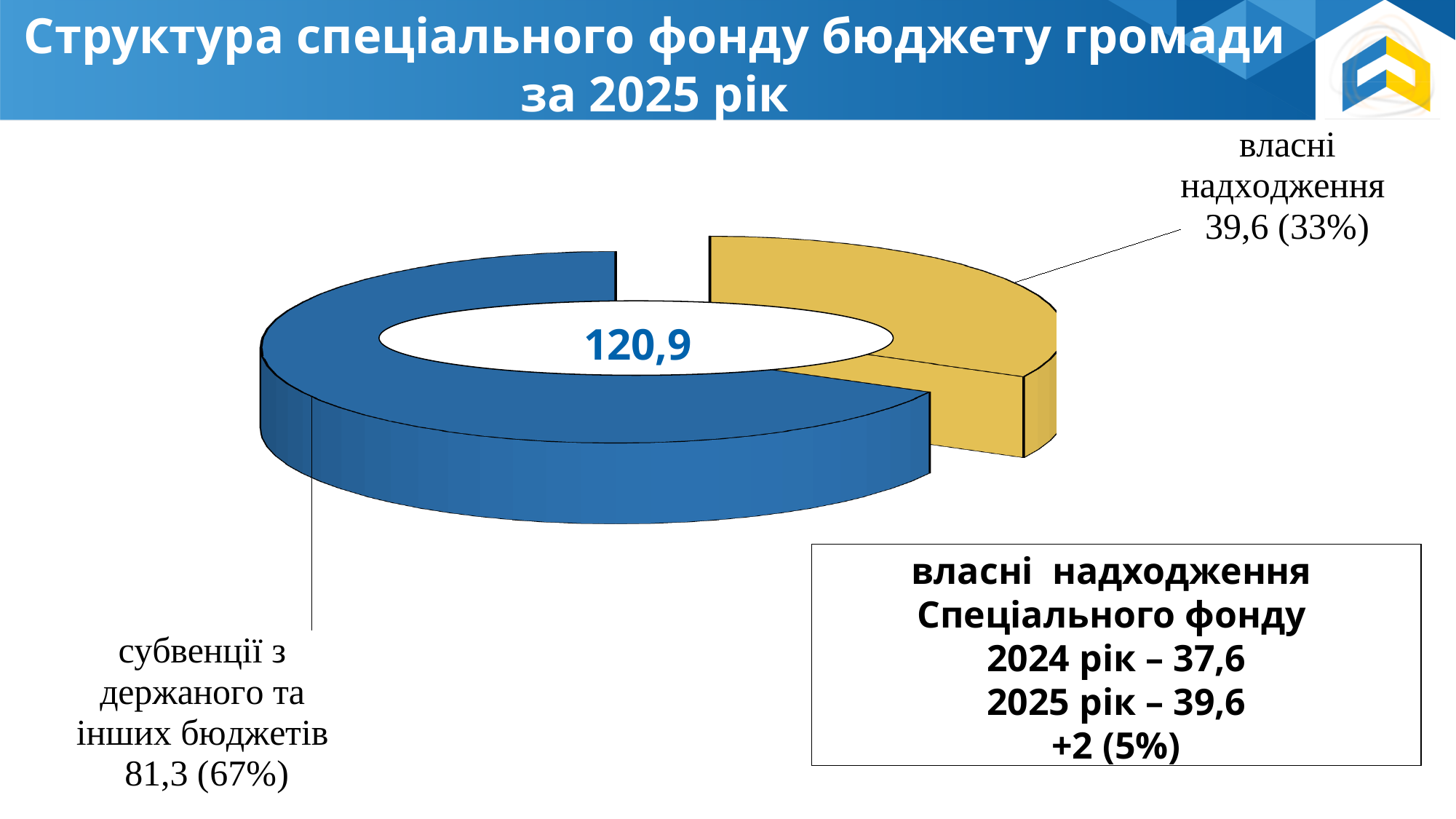
What is the difference between the values for "субвенції з держаного та інших бюджетів" and "власні надходження"? 41,7 How many segments does the doughnut chart have? 2 What share of the doughnut chart does "власні надходження" represent? 33% Which segment of the doughnut chart is the smallest? власні надходження What is the title of the slide containing the doughnut chart? Структура спеціального фонду бюджету громади за 2025 рік What total value is shown in the centre of the doughnut chart? 120,9 What share of the doughnut chart does "субвенції з держаного та інших бюджетів" represent? 67% Which colour is used for the "власні надходження" segment of the doughnut chart? yellow What is the value for "власні надходження" in the doughnut chart? 39,6 Which segment of the doughnut chart is the largest? субвенції з держаного та інших бюджетів What kind of chart is shown on the slide? doughnut chart What is the value for "субвенції з держаного та інших бюджетів" in the doughnut chart? 81,3